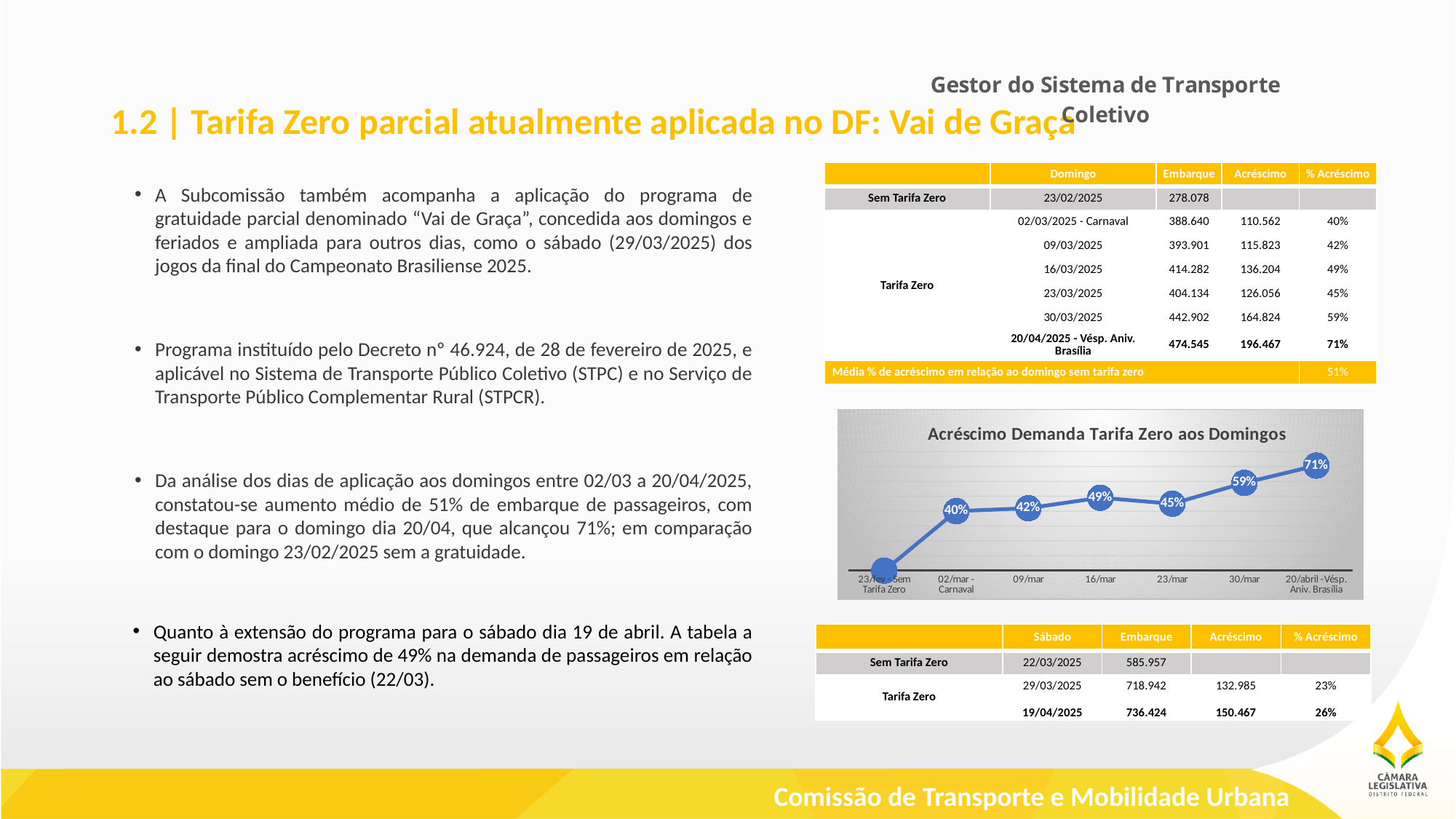
In the chart "Acréscimo Demanda Tarifa Zero aos Domingos", what is the difference between the values for 20/abril - Vésp. Aniv. Brasília and 02/mar - Carnaval? 31% In the chart "Acréscimo Demanda Tarifa Zero aos Domingos", what is the value for 02/mar - Carnaval? 40% How many data points are plotted in the chart "Acréscimo Demanda Tarifa Zero aos Domingos"? 7 In the chart "Acréscimo Demanda Tarifa Zero aos Domingos", which date has the lowest value among those with a percentage label? 02/mar - Carnaval In the chart "Acréscimo Demanda Tarifa Zero aos Domingos", what is the value for 16/mar? 49% What is the title of the line chart on the slide? Acréscimo Demanda Tarifa Zero aos Domingos In the chart "Acréscimo Demanda Tarifa Zero aos Domingos", which is larger: the value for 16/mar or the value for 23/mar? 16/mar What type of chart is shown under the title "Acréscimo Demanda Tarifa Zero aos Domingos"? Line chart In the chart "Acréscimo Demanda Tarifa Zero aos Domingos", do the values generally rise or fall from 02/mar - Carnaval to 20/abril - Vésp. Aniv. Brasília? Rise In the chart "Acréscimo Demanda Tarifa Zero aos Domingos", what is the value for 20/abril - Vésp. Aniv. Brasília? 71% In the chart "Acréscimo Demanda Tarifa Zero aos Domingos", what is the value for 30/mar? 59% In the chart "Acréscimo Demanda Tarifa Zero aos Domingos", which labelled date has the highest value? 20/abril - Vésp. Aniv. Brasília